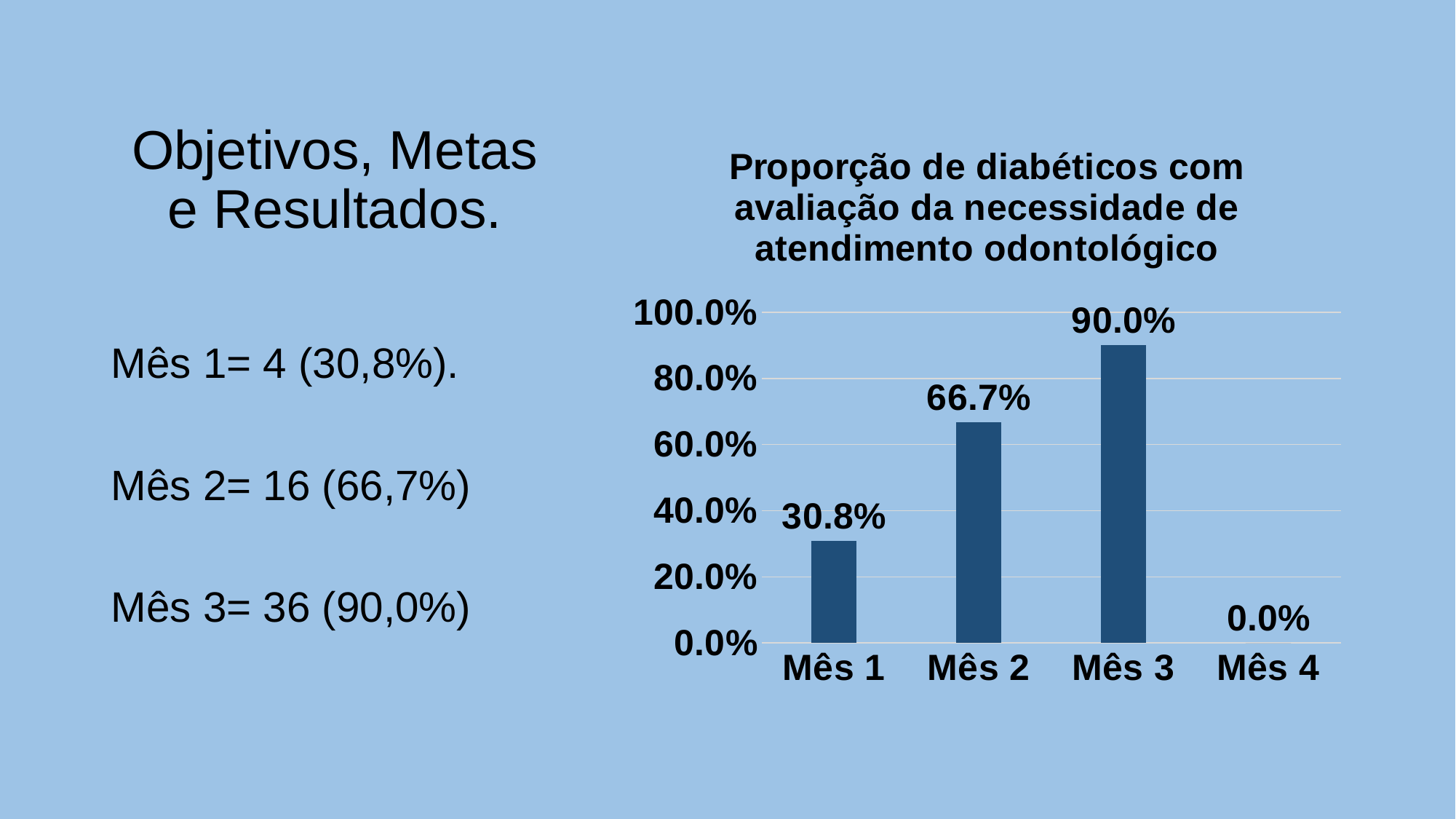
Which is larger, the value for Mês 1 or the value for Mês 2? Mês 2 What kind of chart is shown on the slide? Bar chart What is the difference between the values for Mês 3 and Mês 2? 23.3% What is the title of the chart? Proporção de diabéticos com avaliação da necessidade de atendimento odontológico What is the value for Mês 4? 0.0% What is the value for Mês 1? 30.8% How many categories are shown on the x axis? 4 Which month has the lowest value? Mês 4 What is the value for Mês 3? 90.0% What is the value for Mês 2? 66.7% What is the difference between the values for Mês 2 and Mês 1? 35.9% Which month has the highest value? Mês 3